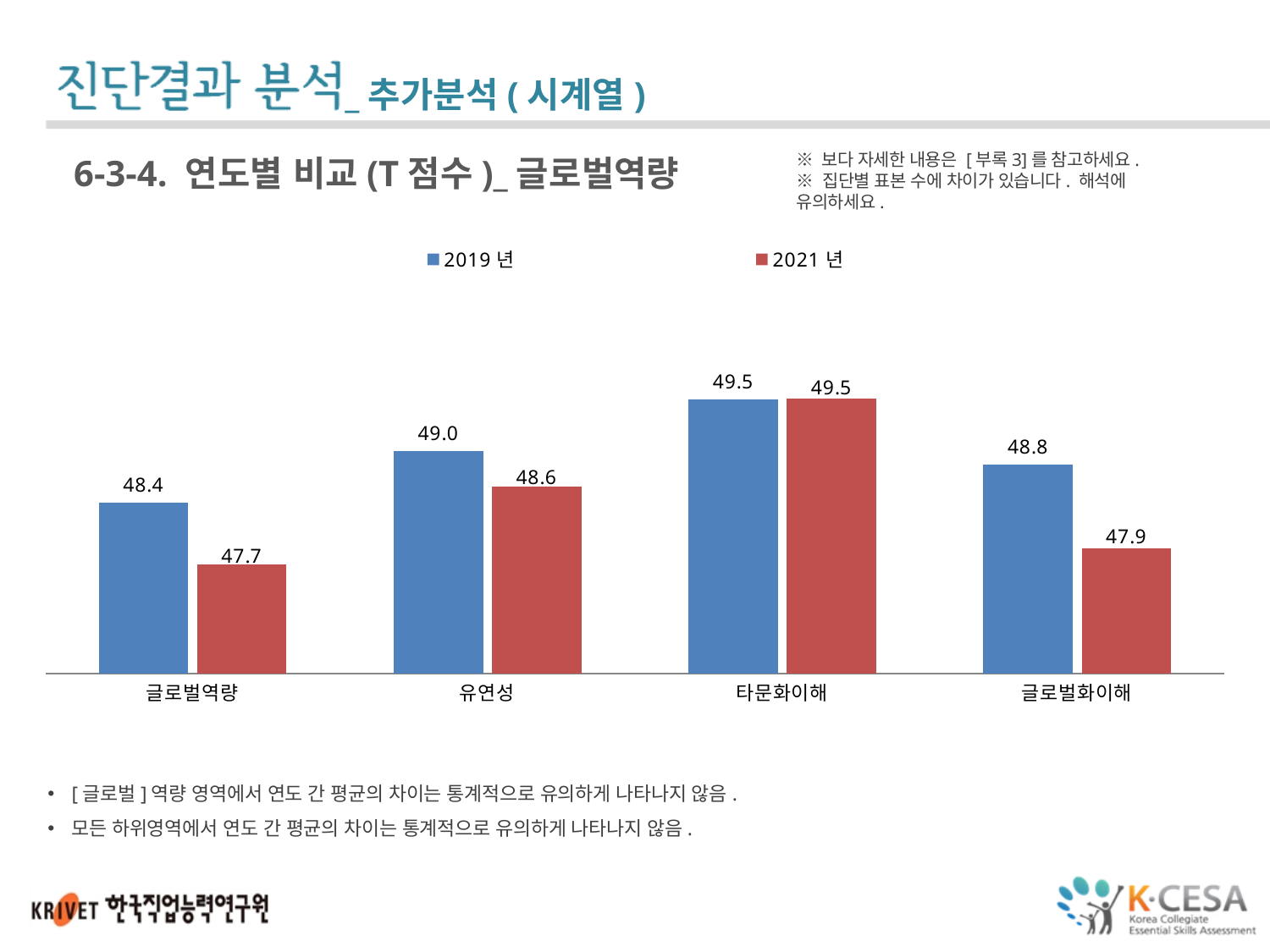
How many categories are shown on the x axis? 4 What is the difference between the 2019 년 and 2021 년 values for 글로벌역량? 0.7 What is the 2021 년 value for 유연성? 48.6 How many series does the legend list? 2 Which category has the lowest 2021 년 value? 글로벌역량 What is the 2021 년 value for 글로벌화이해? 47.9 What is the 2019 년 value for 글로벌역량? 48.4 What is the 2019 년 value for 타문화이해? 49.5 Which is larger for 유연성, the 2019 년 value or the 2021 년 value? 2019 년 What kind of chart is shown on the slide? Bar chart What is the difference between the 2019 년 and 2021 년 values for 글로벌화이해? 0.9 Which category has the highest 2019 년 value? 타문화이해